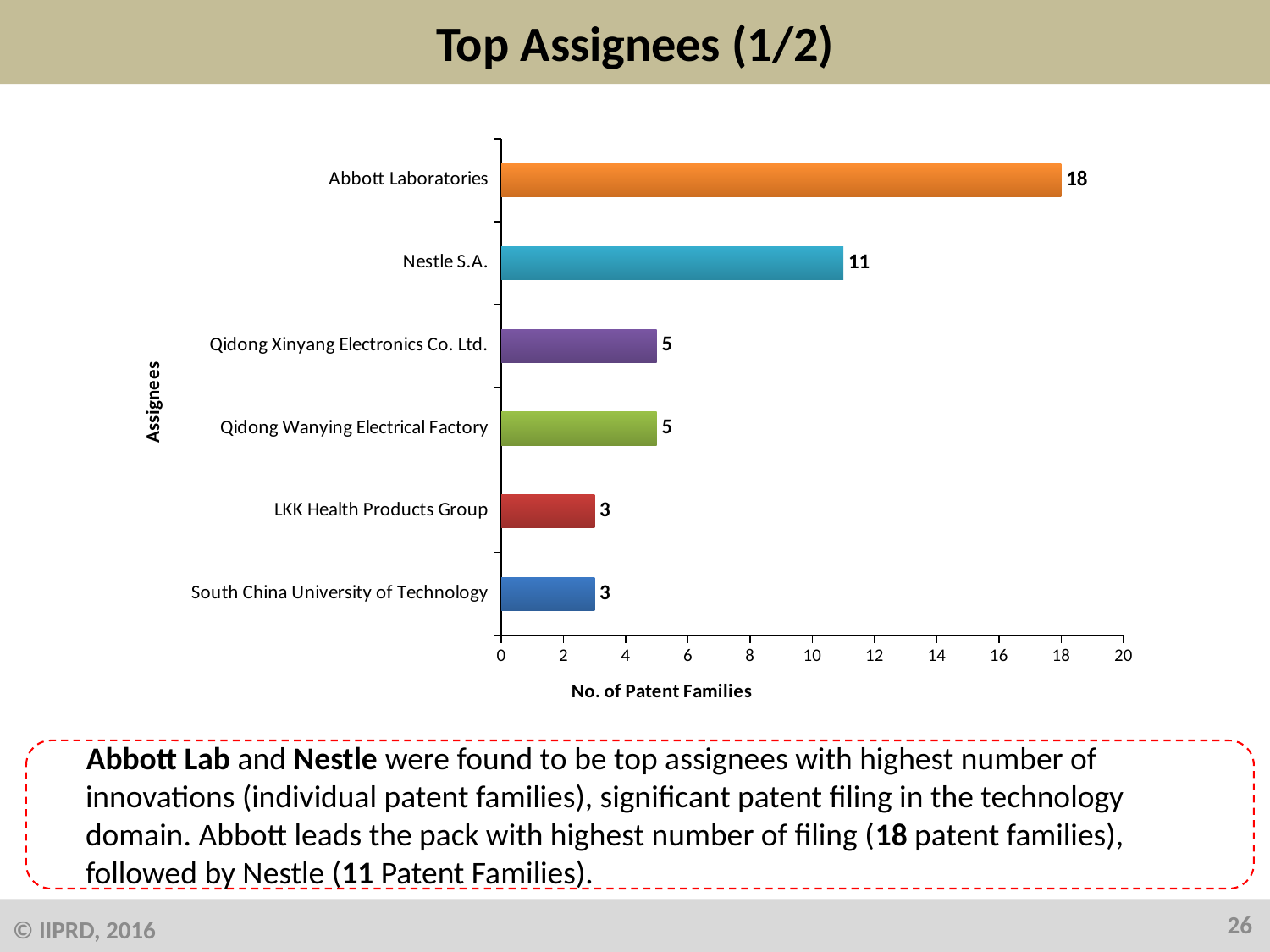
What is the label of the vertical axis? Assignees How many patent families does Abbott Laboratories have? 18 What is the label of the horizontal axis? No. of Patent Families What is the number of patent families for Nestle S.A.? 11 What is the difference in patent families between Abbott Laboratories and Nestle S.A.? 7 Which assignee has the highest number of patent families? Abbott Laboratories What is the difference in patent families between Qidong Xinyang Electronics Co. Ltd. and South China University of Technology? 2 What is the value for LKK Health Products Group? 3 How many assignees are shown in the chart? 6 Which has more patent families, Nestle S.A. or Qidong Wanying Electrical Factory? Nestle S.A. What type of chart is shown on the slide? Bar chart How many patent families does Qidong Xinyang Electronics Co. Ltd. have? 5